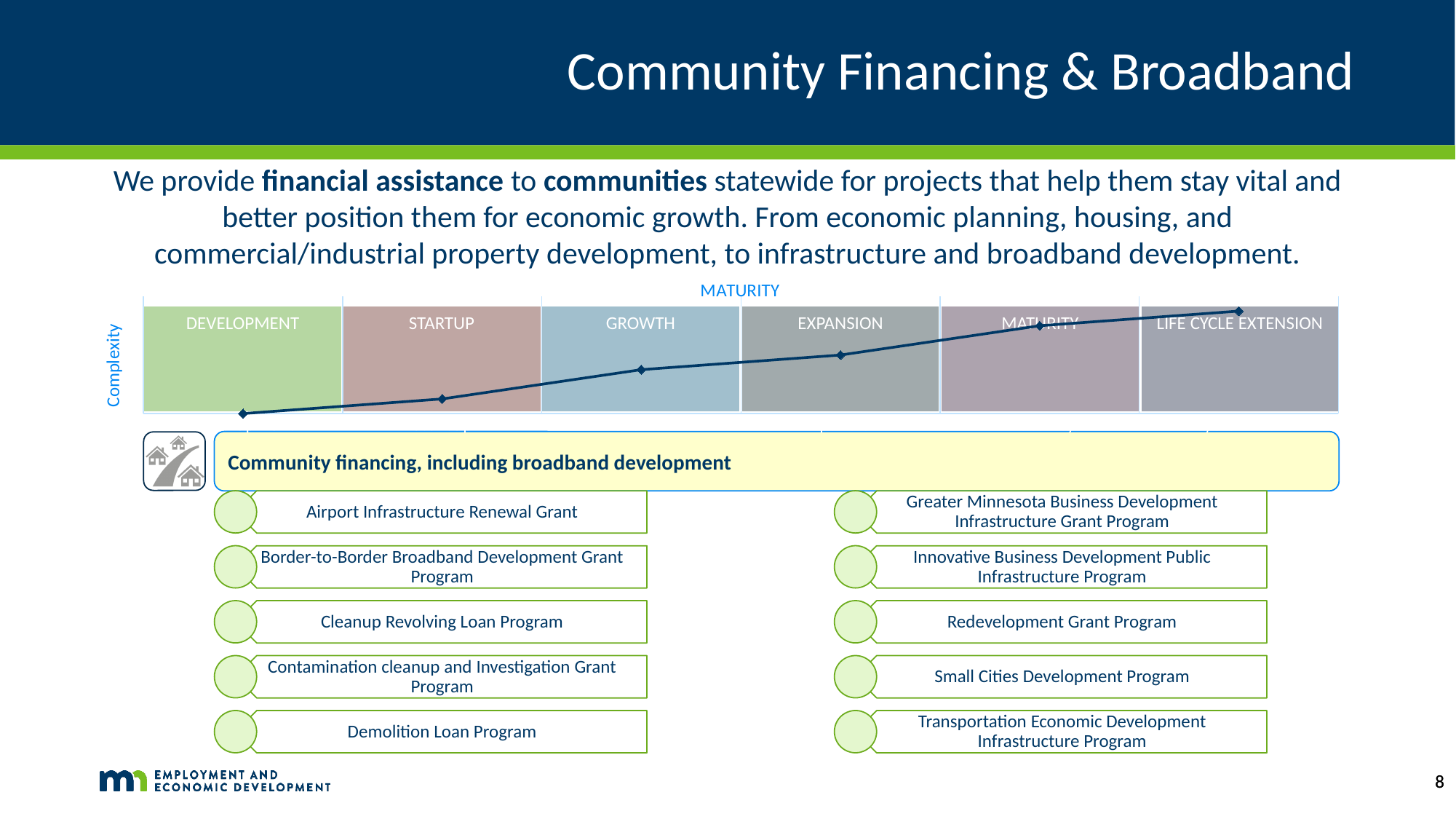
In the chart, is the point for GROWTH higher or lower than the point for STARTUP? Higher Which stage is the first category on the x axis of the chart? DEVELOPMENT Which stage has the highest point on the line in the chart? LIFE CYCLE EXTENSION What is the label on the x axis of the chart? MATURITY Which stage has the lowest point on the line in the chart? DEVELOPMENT What kind of chart is shown in the middle of the slide, with the stages from DEVELOPMENT to LIFE CYCLE EXTENSION? Line chart Does the line in the chart rise or fall as it moves from DEVELOPMENT to LIFE CYCLE EXTENSION? Rise Which stage comes immediately after GROWTH on the x axis of the chart? EXPANSION How many stages (categories) are shown along the x axis of the chart? 6 In the chart, is the point for EXPANSION higher or lower than the point for MATURITY? Lower What is the label on the y axis of the chart? Complexity